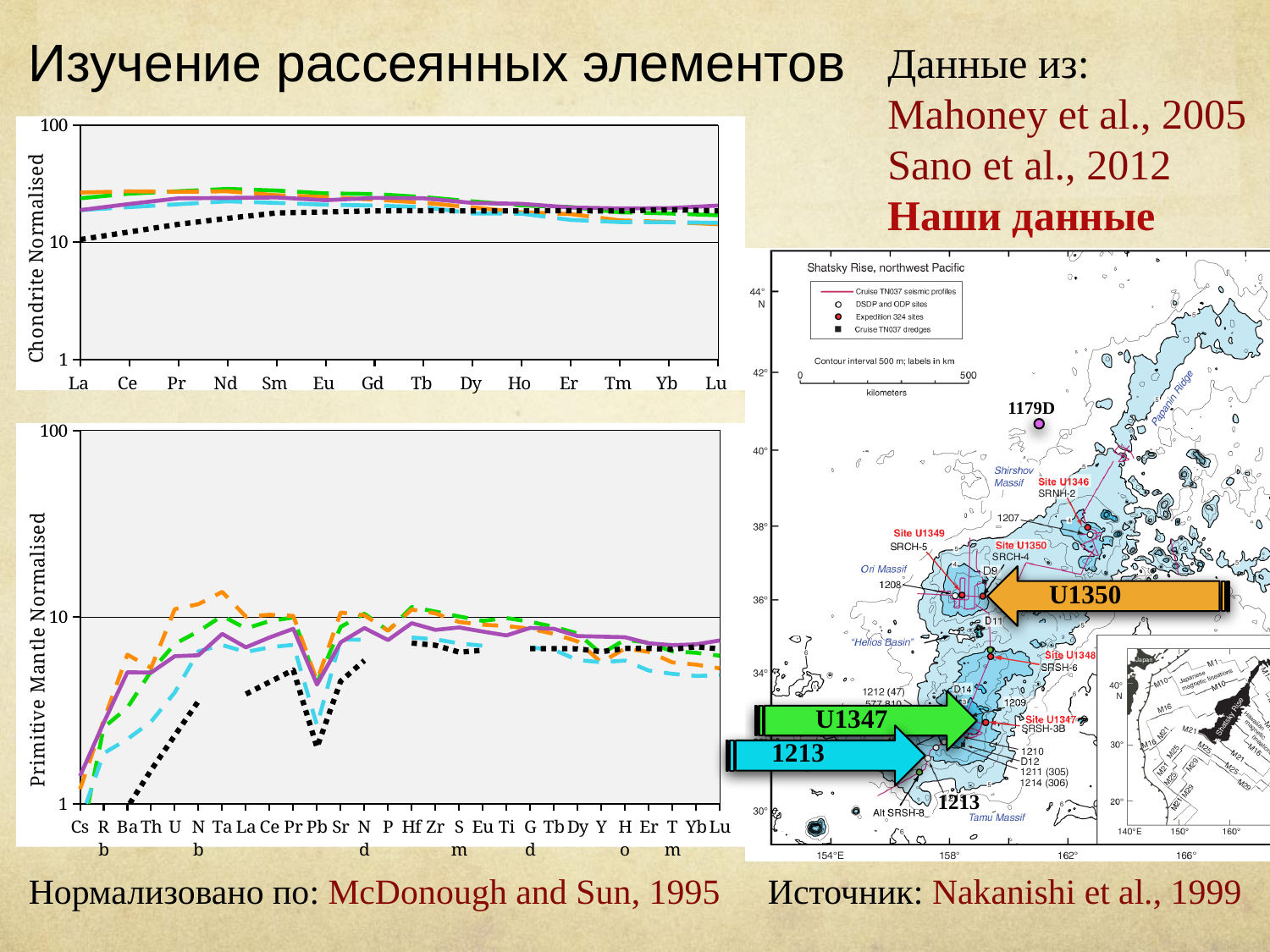
In the bottom chart, is the value of the black dotted line at Pb greater or less than 10? less In the top chart, does the black dotted line rise or fall from La to Lu? rise What kind of chart is the top chart (Chondrite Normalised)? line chart In the top chart, is the value of the orange dashed line at Nd greater or less than 10? greater What kind of chart is the bottom chart (Primitive Mantle Normalised)? line chart In the bottom chart, is the value of the orange dashed line at Ta greater or less than 10? greater In the top chart, what is the label of the y axis? Chondrite Normalised In the top chart (Chondrite Normalised), how many elements are listed along the x axis? 14 In the bottom chart (Primitive Mantle Normalised), how many elements are listed along the x axis? 28 In the bottom chart, what is the label of the y axis? Primitive Mantle Normalised In the top chart, does the orange dashed line rise or fall from La to Lu? fall